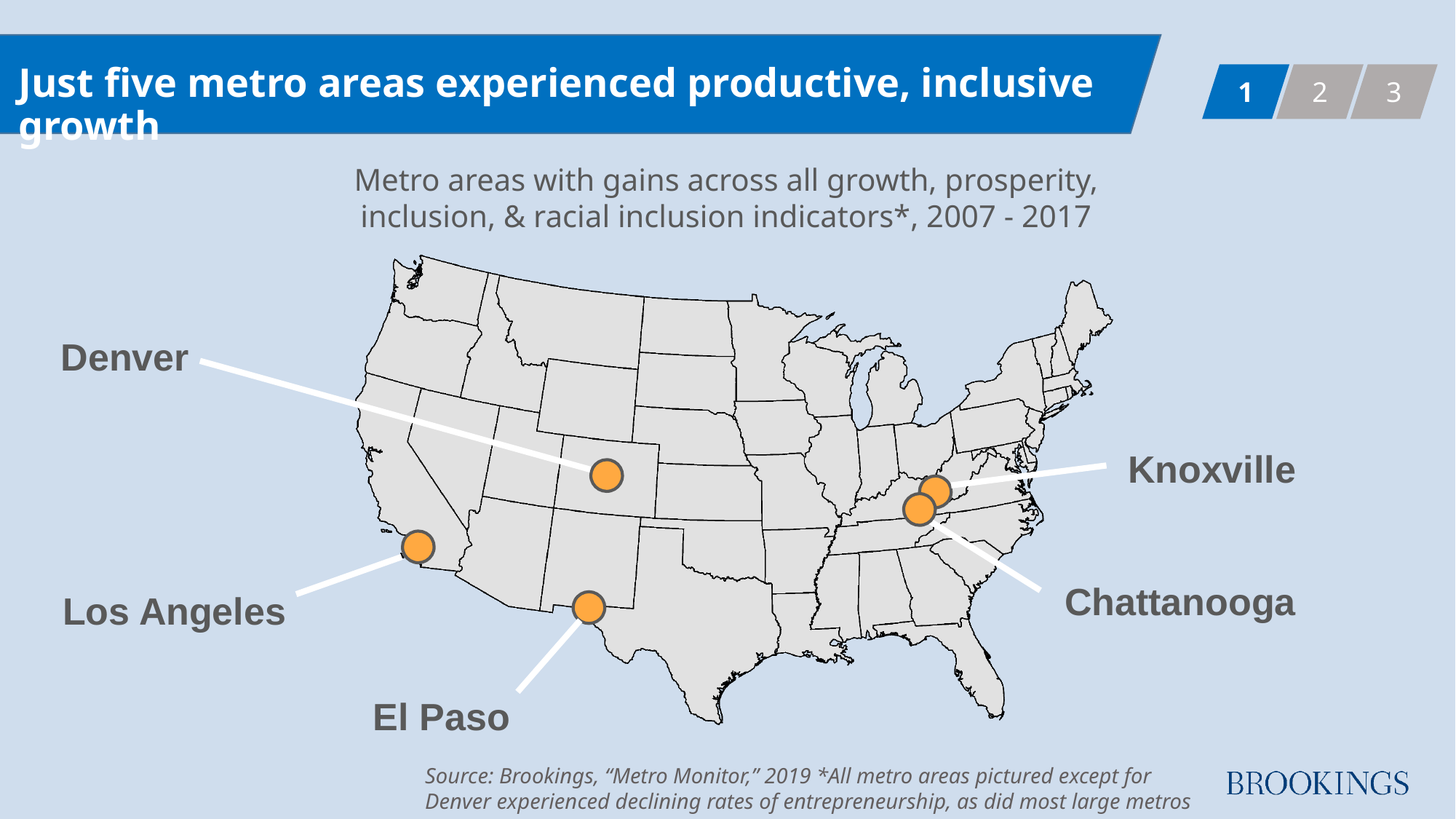
How many metro areas are marked on the map? 5 According to the footnote, which pictured metro area did not experience declining rates of entrepreneurship? Denver What colour are the markers for the metro areas on the map? Orange Which two marked metro areas are located closest to each other on the map? Knoxville and Chattanooga What is the source of the map chart? Brookings, "Metro Monitor," 2019 What time period does the map chart cover? 2007 - 2017 Which marked metro area is located in Colorado on the map? Denver Which marked metro area is located furthest south on the map? El Paso What is the title of the map chart? Metro areas with gains across all growth, prosperity, inclusion, & racial inclusion indicators*, 2007 - 2017 Which marked metro area is located furthest west on the map? Los Angeles What kind of chart is shown on the slide? A map Which metro areas are marked on the map? Denver, Los Angeles, El Paso, Knoxville, Chattanooga